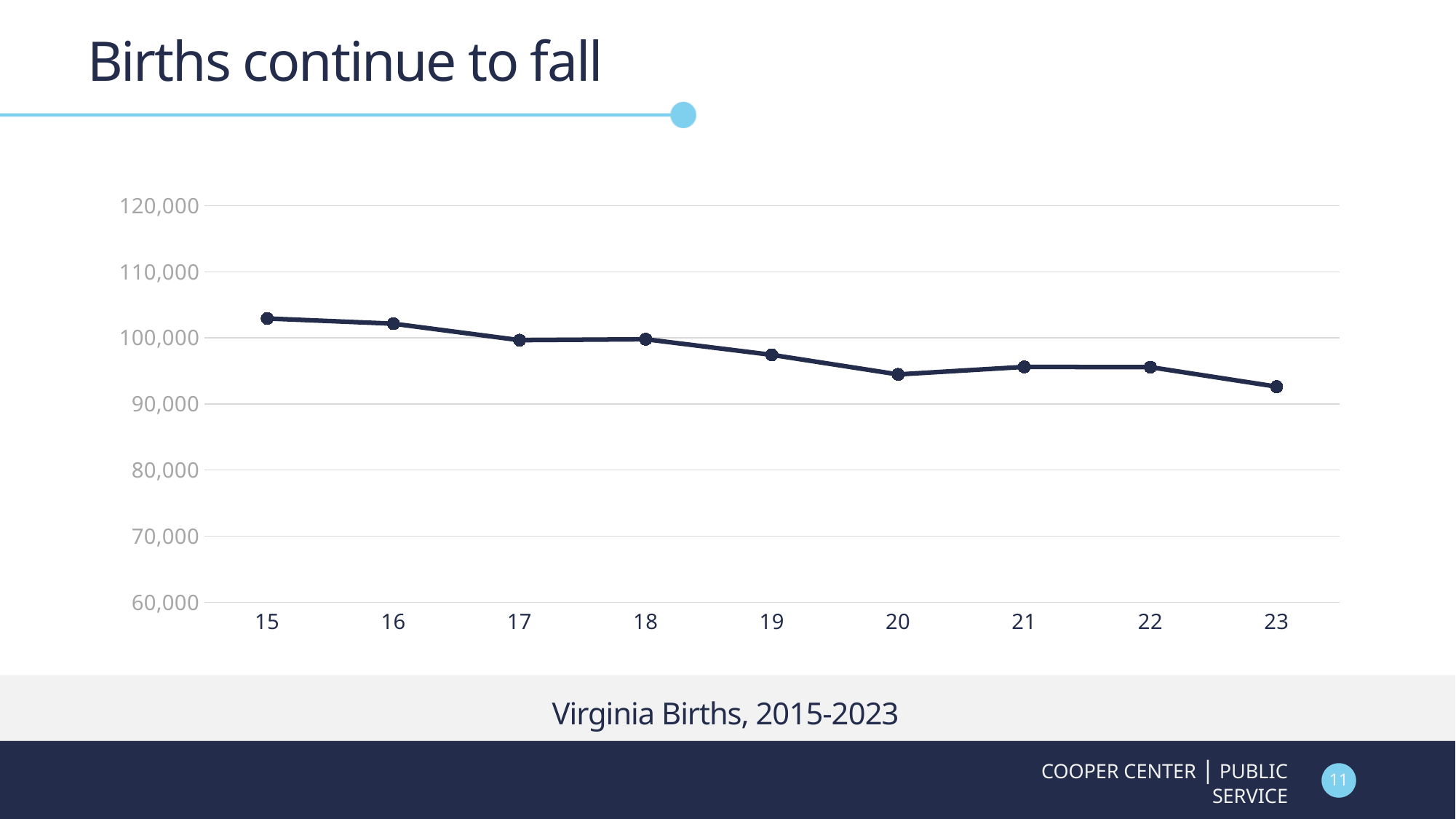
Which year has the lowest number of births? 23 What kind of chart is shown on the slide? line chart What is the caption shown below the chart? Virginia Births, 2015-2023 Is the value for 15 greater or less than 100,000? greater Is the value for 20 greater or less than 90,000? greater Which year has the highest number of births? 15 How many data points are plotted on the line? 9 Which year has the larger value, 16 or 20? 16 What is the title of the slide? Births continue to fall Is the value for 23 greater or less than 100,000? less Do the values generally rise or fall from 15 to 23 along the x axis? fall